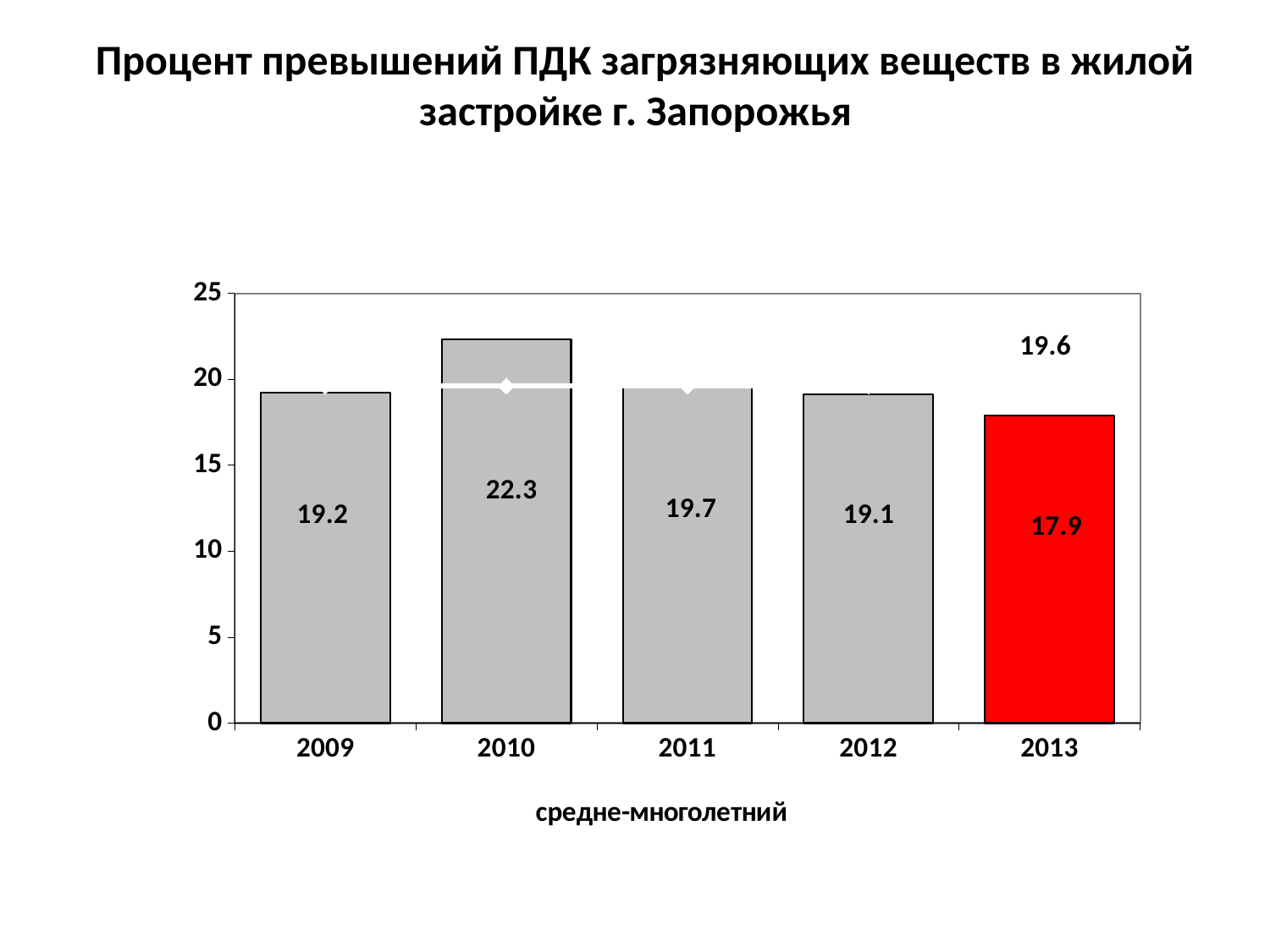
What is the value of the 'средне-многолетний' line? 19.6 What kind of chart is this? Bar chart What is the difference between the values for 2011 and 2012? 0.6 Which is larger, the value for 2009 or the value for 2011? 2011 What is the value for 2013? 17.9 What is the difference between the values for 2010 and 2013? 4.4 What is the value for 2010? 22.3 Which bar is coloured red? 2013 How many years are shown on the x axis? 5 Which year has the highest bar? 2010 Which year has the lowest bar? 2013 What is the value for 2009? 19.2